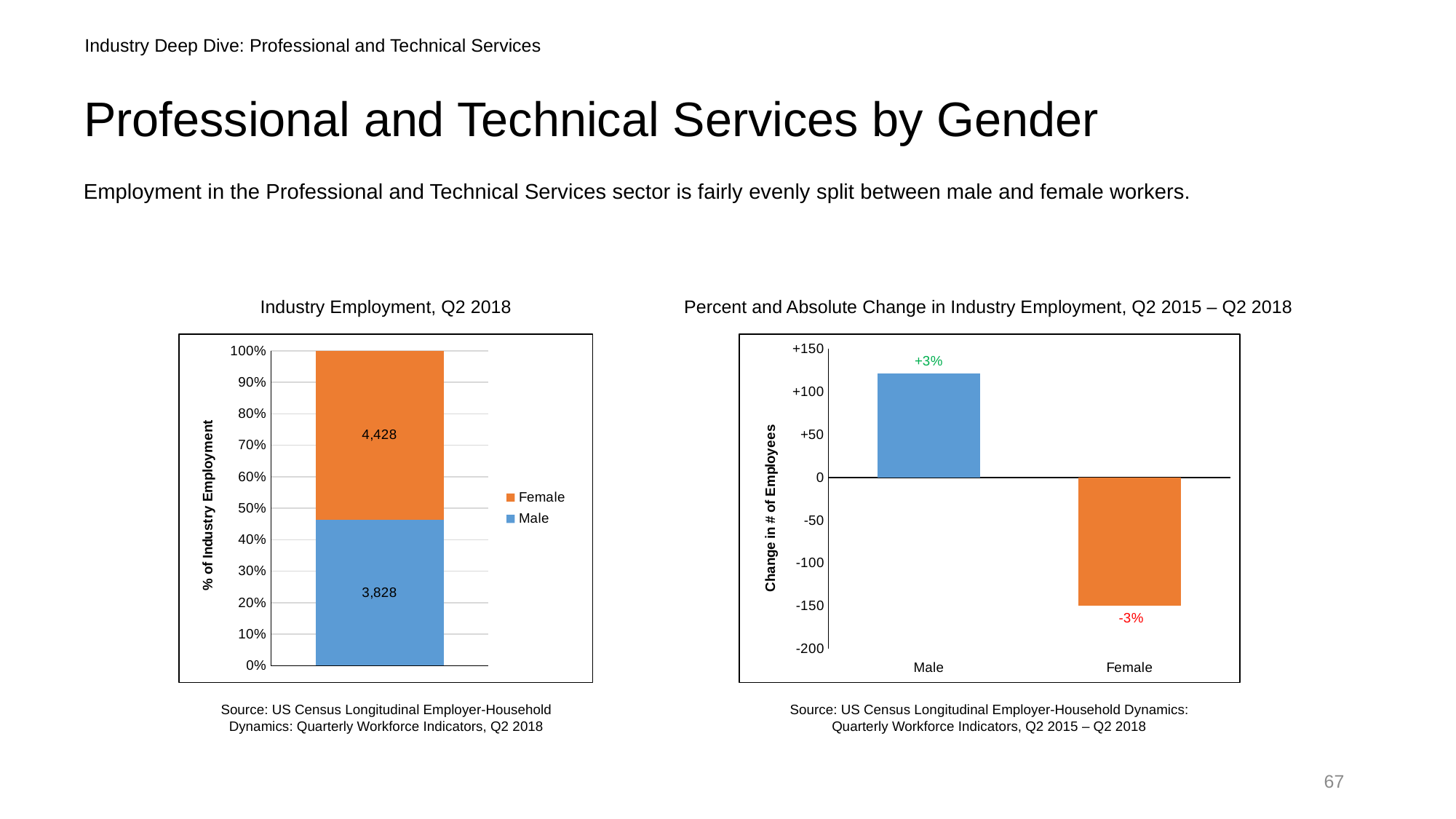
In the 'Percent and Absolute Change in Industry Employment, Q2 2015 – Q2 2018' chart, what is the title of the vertical axis? Change in # of Employees In the 'Industry Employment, Q2 2018' chart, what is the value shown for Female? 4,428 In the 'Percent and Absolute Change in Industry Employment, Q2 2015 – Q2 2018' chart, is the change in number of employees for Female greater or less than -100? less In the 'Percent and Absolute Change in Industry Employment, Q2 2015 – Q2 2018' chart, what percent change is labelled for Female? -3% What kind of chart is the 'Industry Employment, Q2 2018' chart? Stacked bar chart In the 'Industry Employment, Q2 2018' chart, what is the value shown for Male? 3,828 In the 'Percent and Absolute Change in Industry Employment, Q2 2015 – Q2 2018' chart, what percent change is labelled for Male? +3% In the 'Industry Employment, Q2 2018' chart, how many series does the legend list? 2 In the 'Industry Employment, Q2 2018' chart, which is larger, the Female value or the Male value? Female In the 'Industry Employment, Q2 2018' chart, what is the total of the stacked bar (Female plus Male)? 8,256 In the 'Percent and Absolute Change in Industry Employment, Q2 2015 – Q2 2018' chart, is the change in number of employees for Male greater or less than +100? greater In the 'Industry Employment, Q2 2018' chart, what is the difference between the Female and Male values? 600